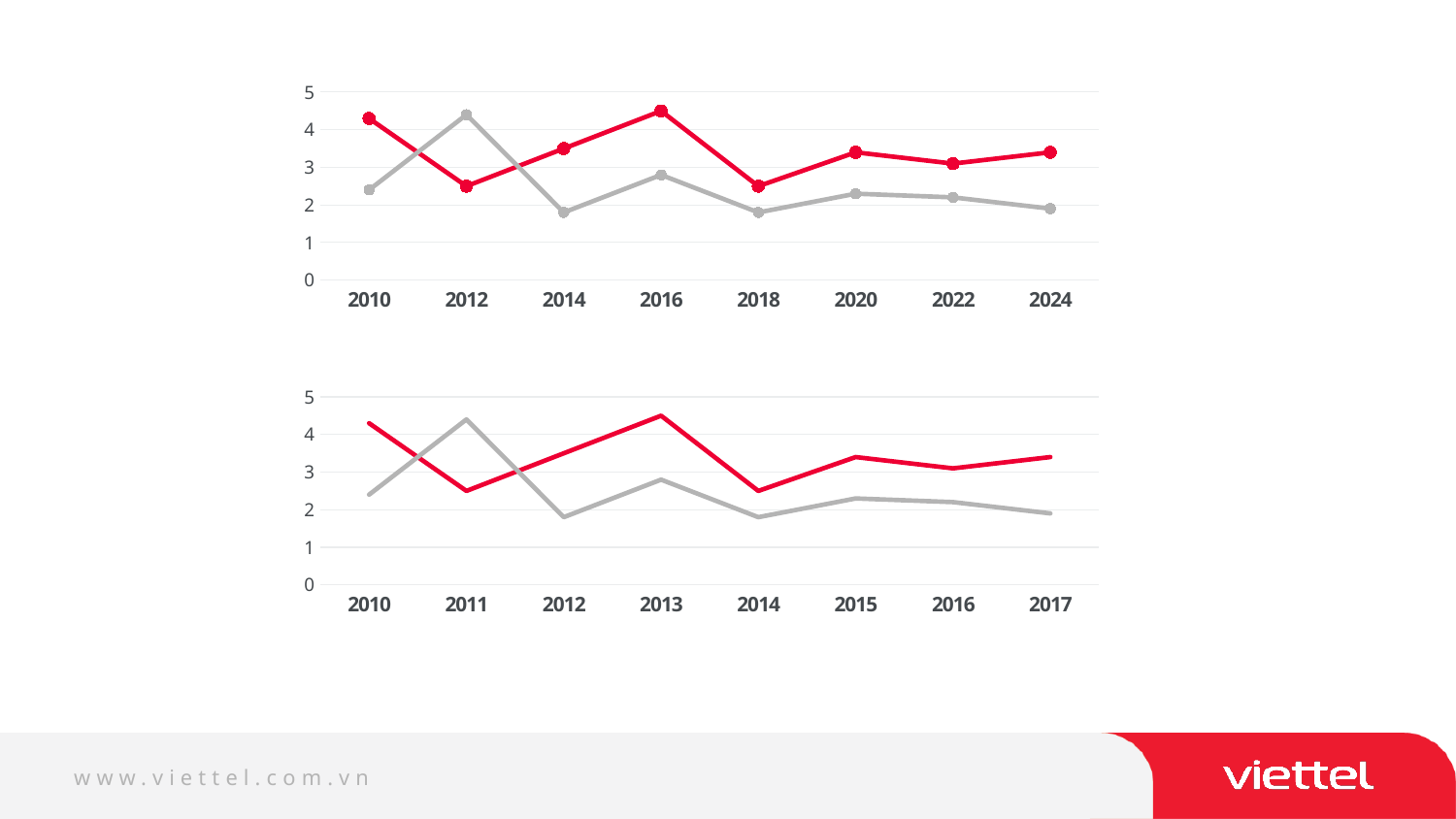
In the top chart, which line is higher at 2012, the red line or the grey line? the grey line In the bottom chart, is the value of the red line for 2013 greater or less than 4? greater In the bottom chart, is the value of the grey line for 2011 greater or less than 4? greater In the top chart, in which year does the red line reach its highest value? 2016 In the top chart, is the value of the grey line for 2014 greater or less than 2? less How many lines are plotted in the bottom chart? 2 What kind of chart is the top chart on the slide? line chart How many years are labelled on the x axis of the bottom chart? 8 In the top chart, does the grey line rise or fall from 2020 to 2024? fall How many years are labelled on the x axis of the top chart? 8 In the top chart, in which year does the grey line reach its highest value? 2012